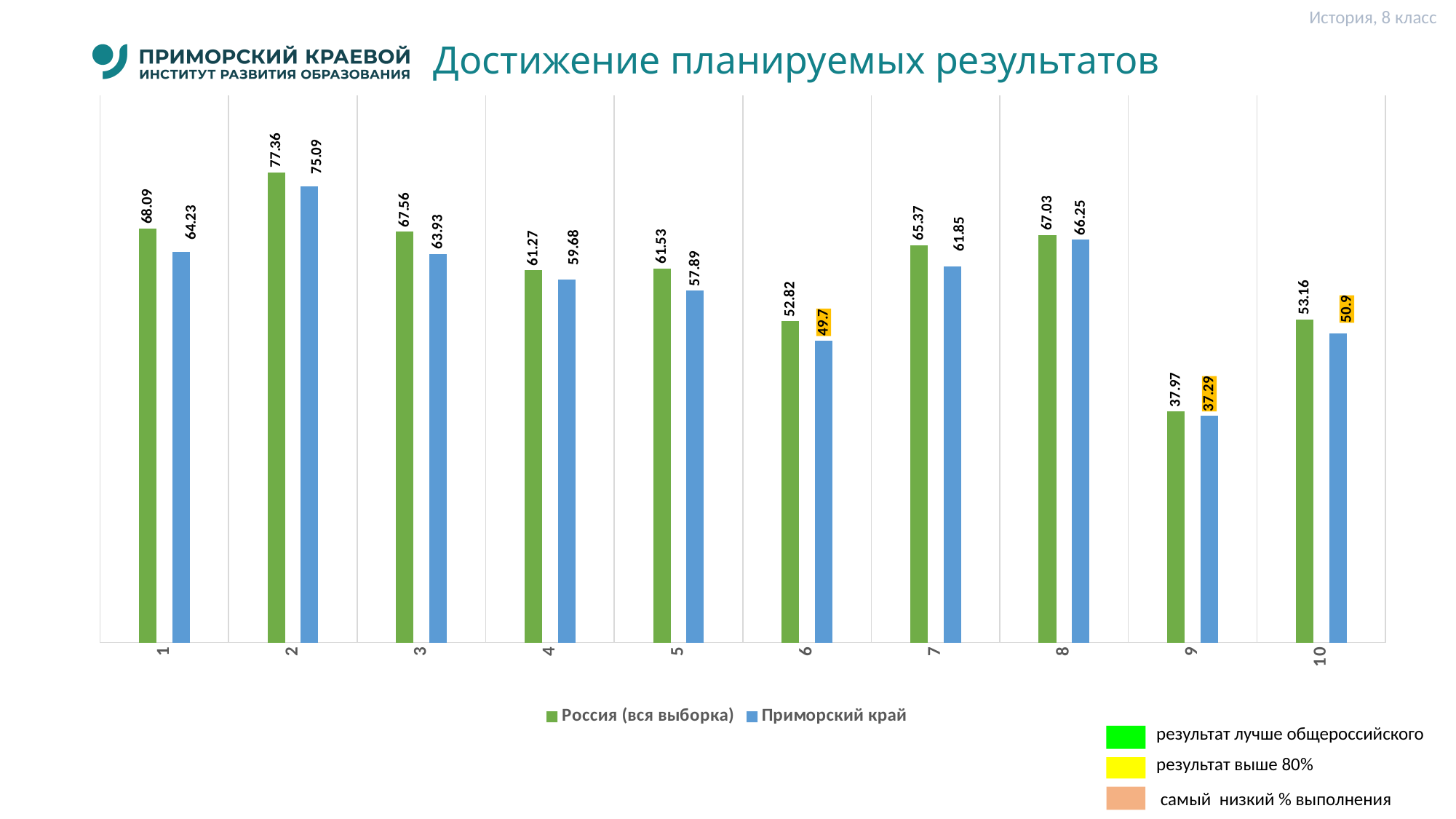
Which category has the lowest value for Россия (вся выборка)? 9 How many categories are shown on the x axis? 10 What is the difference between the Россия (вся выборка) and Приморский край values for category 1? 3.86 Which colour represents the Приморский край series? Blue For category 8, which series has the larger value: Россия (вся выборка) or Приморский край? Россия (вся выборка) What is the difference between the Приморский край values for category 2 and category 9? 37.8 What is the value for Россия (вся выборка) for category 2? 77.36 What is the value for Приморский край for category 10? 50.9 What is the value for Приморский край for category 6? 49.7 Which category has the highest value for Приморский край? 2 How many series does the legend list? 2 What kind of chart is shown on the slide? Bar chart